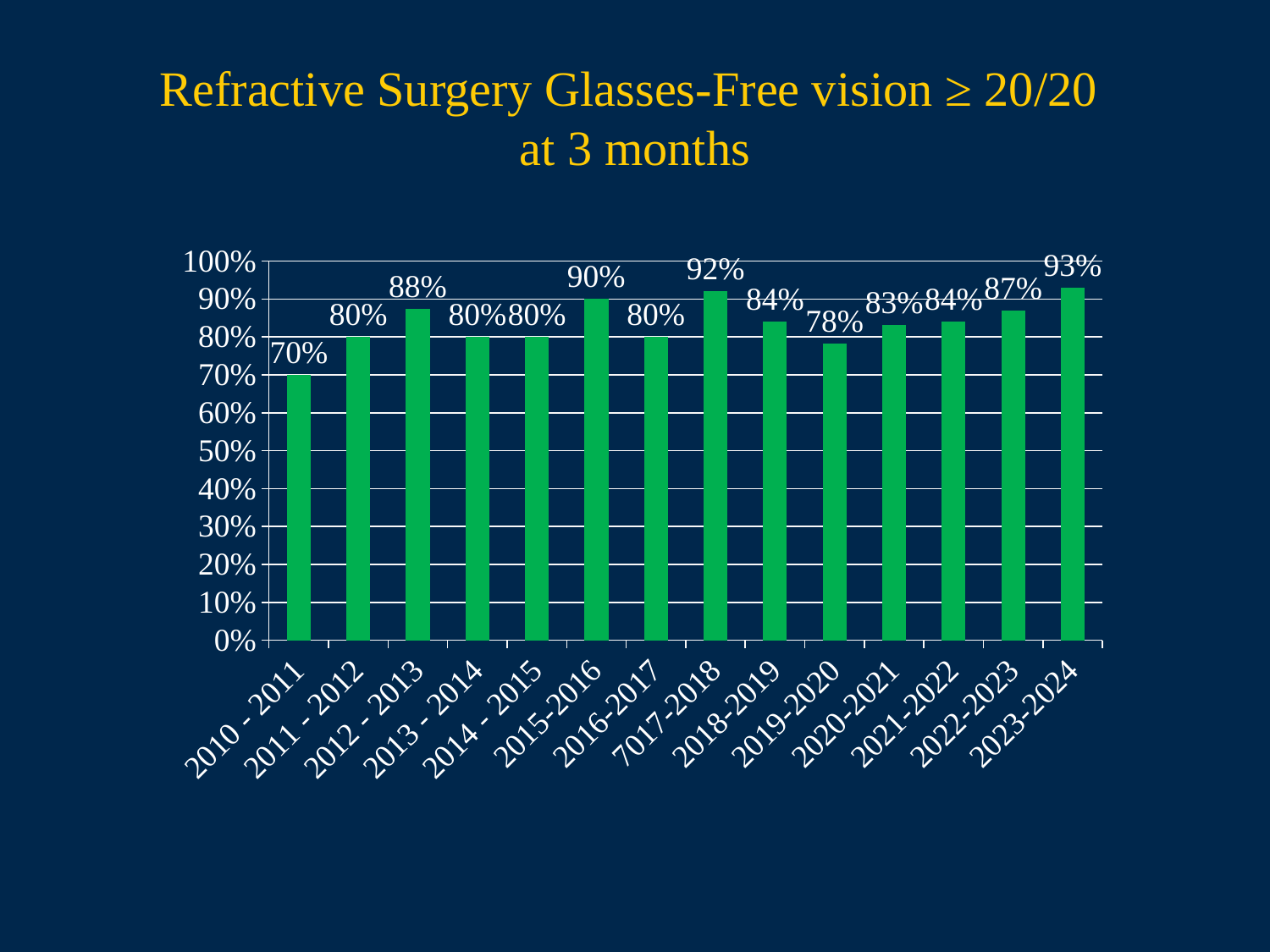
How many bars are shown in the chart? 14 What is the value for 2010 - 2011? 70% What is the difference between the values for 2023-2024 and 2010 - 2011? 23% What is the title of the chart? Refractive Surgery Glasses-Free vision ≥ 20/20 at 3 months What is the value for 2012 - 2013? 88% What is the value for 2019-2020? 78% Which is larger, the value for 2015-2016 or the value for 2018-2019? 2015-2016 Which year has the highest value? 2023-2024 Which year has the lowest value? 2010 - 2011 Is the value for 2019-2020 greater or less than 80%? less What kind of chart is shown on the slide? bar chart What is the value for 2022-2023? 87%